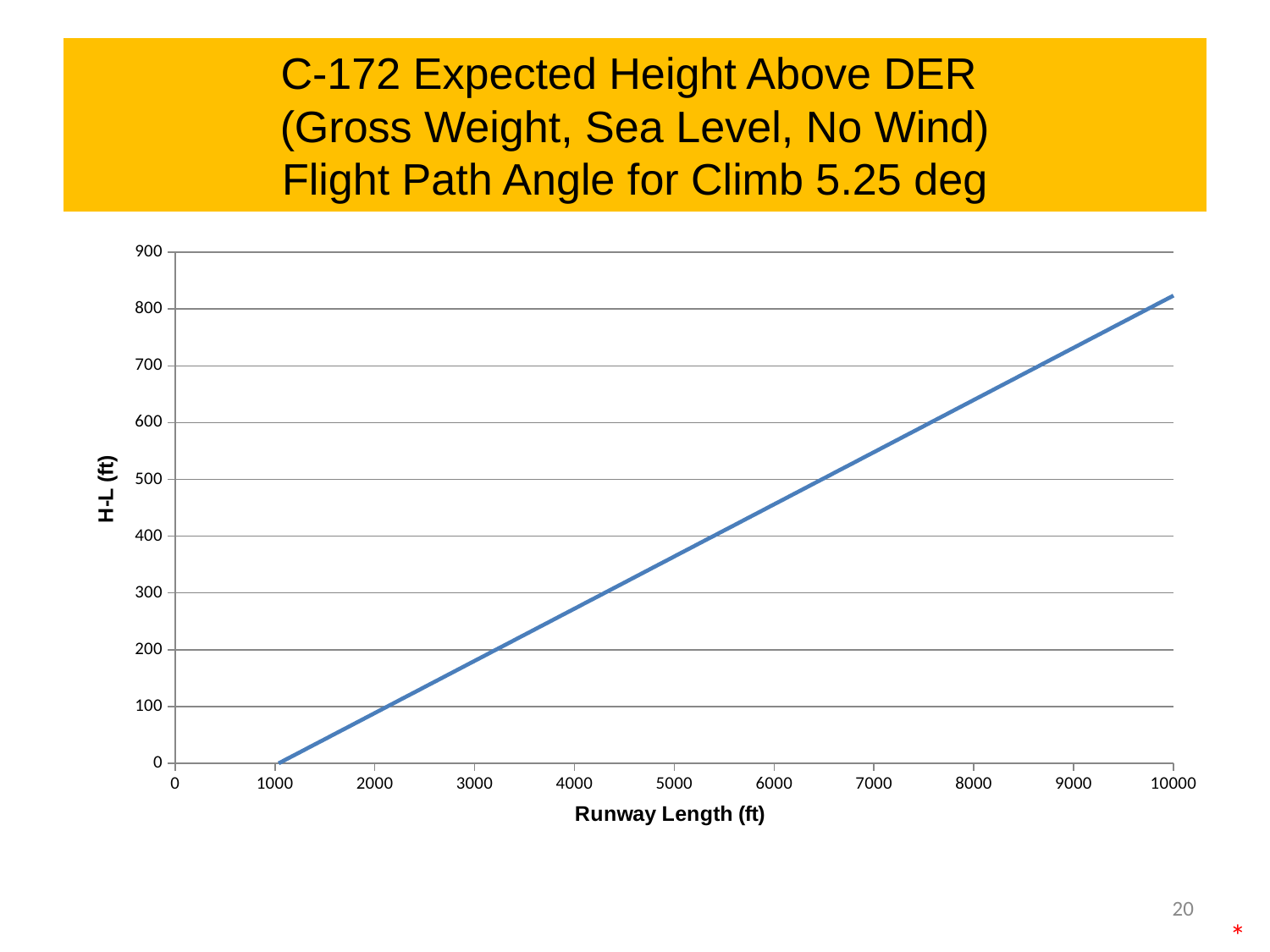
Is the H-L value at a runway length of 5000 ft greater or less than 300? greater Is the H-L value at a runway length of 10000 ft greater or less than 800? greater Is the H-L value at a runway length of 2000 ft greater or less than 200? less What is the title of the vertical axis? H-L (ft) What is the title of the horizontal axis? Runway Length (ft) Does the H-L value rise or fall as runway length increases? rises Is the H-L value higher at a runway length of 7000 ft or at 4000 ft? 7000 ft What kind of chart is shown on the slide? line chart